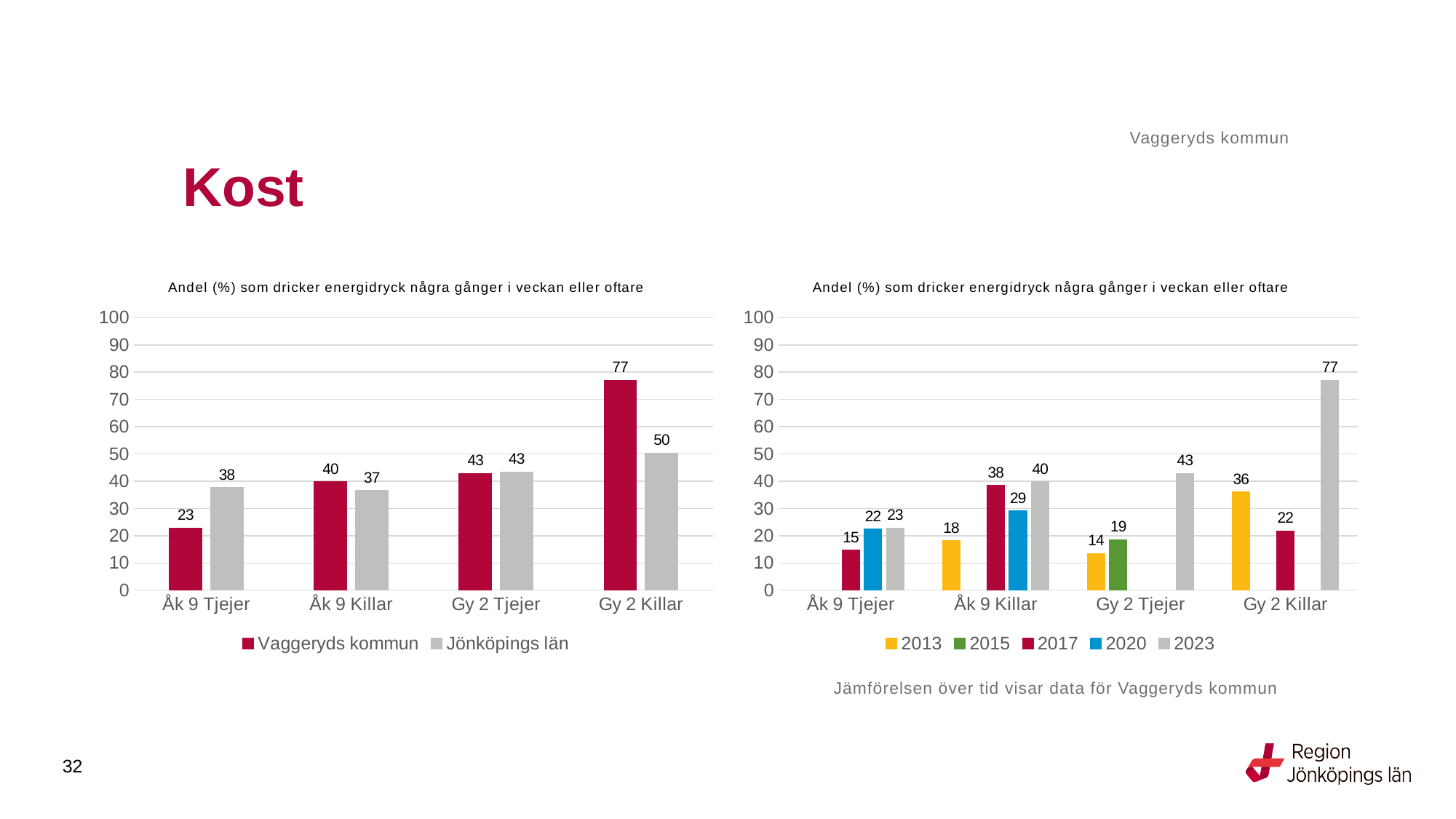
In the right chart, what is the difference between the 2013 and 2017 values for Gy 2 Killar? 14 What kind of chart is the left chart? Bar chart In the left chart, what is the difference between Vaggeryds kommun and Jönköpings län for Gy 2 Killar? 27 In the left chart, what is the value for Jönköpings län for Åk 9 Tjejer? 38 In the left chart, what is the value for Vaggeryds kommun for Gy 2 Killar? 77 In the right chart, what is the value for 2015 for Gy 2 Tjejer? 19 In the right chart, which category has the highest value for 2023? Gy 2 Killar In the right chart, what is the value for 2020 for Åk 9 Killar? 29 In the left chart, how many series does the legend list? 2 In the left chart, which is larger for Åk 9 Killar: Vaggeryds kommun or Jönköpings län? Vaggeryds kommun In the left chart, which category has the lowest value for Vaggeryds kommun? Åk 9 Tjejer In the right chart, how many series does the legend list? 5